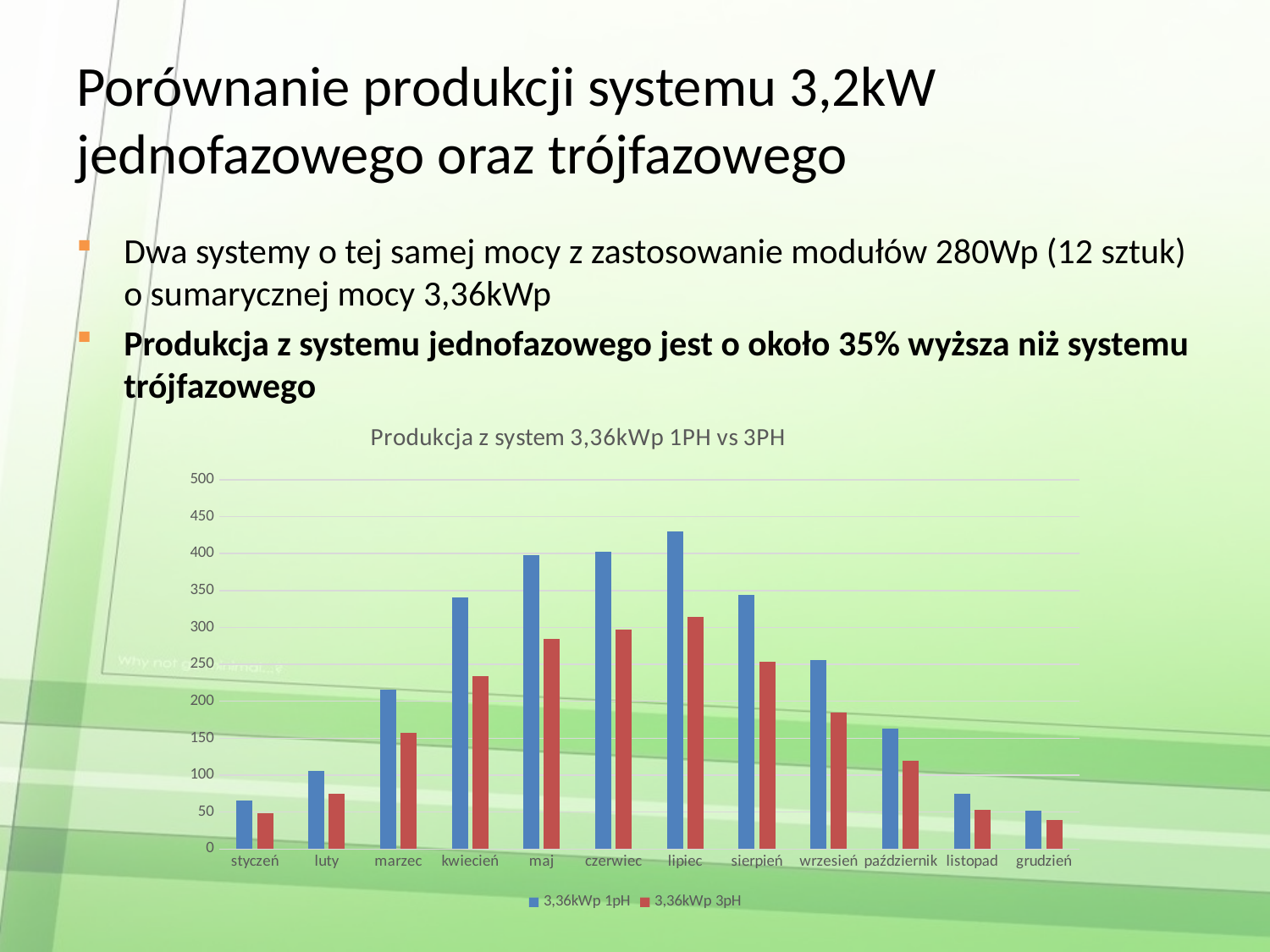
How many months (categories) are shown on the x axis of the chart? 12 In which month is the value for the 3,36kWp 1pH series lowest? grudzień In which month is the value for the 3,36kWp 3pH series highest? lipiec What is the title of the chart? Produkcja z system 3,36kWp 1PH vs 3PH Do the values for the 3,36kWp 1pH series rise or fall from lipiec to grudzień? fall In czerwiec, which series has the larger value, 3,36kWp 1pH or 3,36kWp 3pH? 3,36kWp 1pH Is the value for 3,36kWp 1pH in lipiec greater or less than 400? greater Is the value for 3,36kWp 3pH in wrzesień greater or less than 200? less How many series does the chart legend list? 2 In which month is the value for the 3,36kWp 1pH series highest? lipiec What kind of chart is shown on the slide? bar chart Is the value for 3,36kWp 1pH in kwiecień greater or less than 350? less